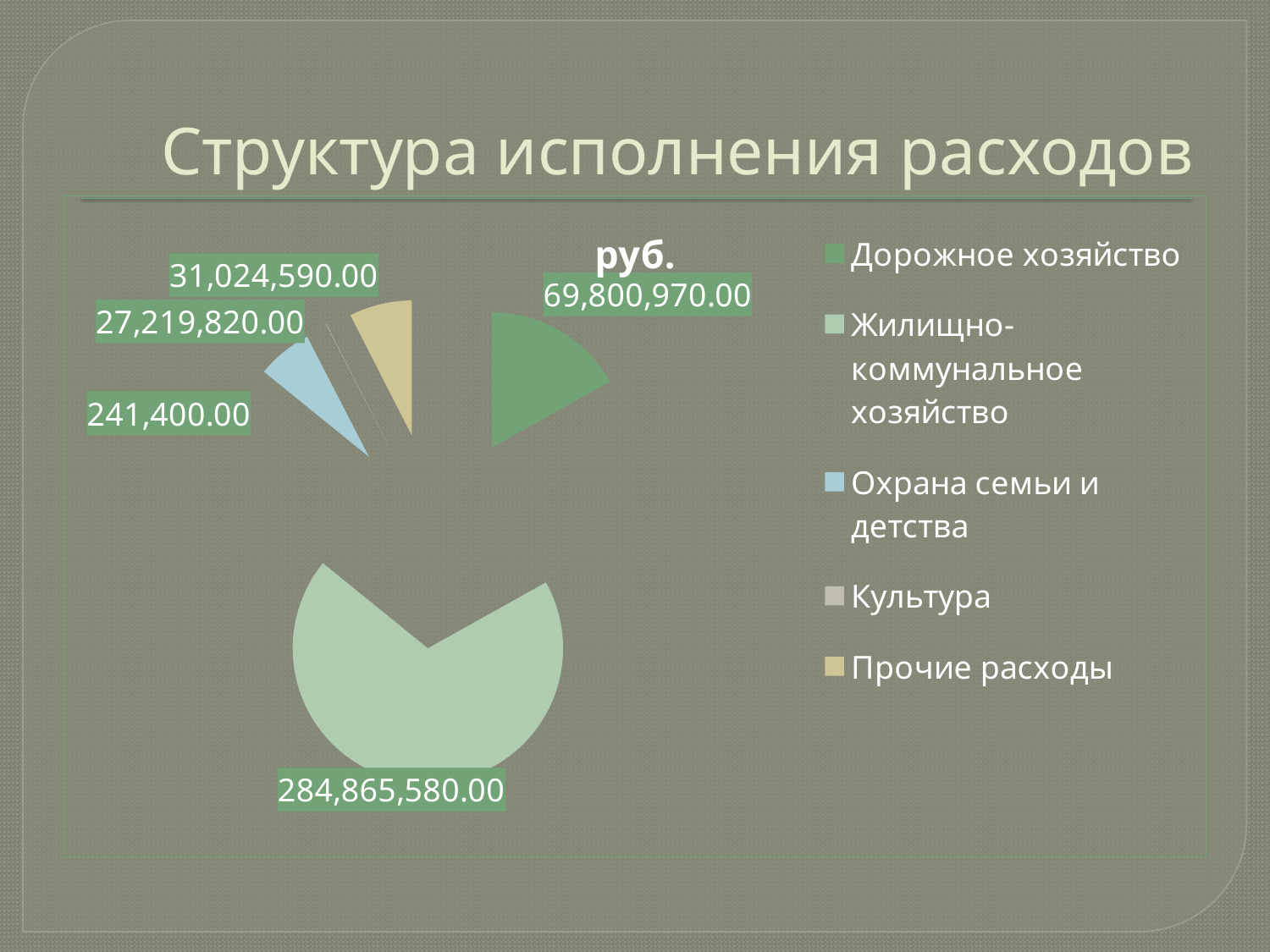
What is the value for Культура? 241,400.00 What is the value for Охрана семьи и детства? 27,219,820.00 What is the value for Жилищно-коммунальное хозяйство? 284,865,580.00 Which category has the largest slice of the pie? Жилищно-коммунальное хозяйство What is the value for Прочие расходы? 31,024,590.00 What kind of chart is shown on the slide? pie chart What is the value for Дорожное хозяйство? 69,800,970.00 Which is larger, the value for Прочие расходы or the value for Охрана семьи и детства? Прочие расходы What is the difference between the values for Жилищно-коммунальное хозяйство and Дорожное хозяйство? 215,064,610.00 Which category has the smallest slice of the pie? Культура How many categories does the legend list? 5 What is the title of the chart? руб.